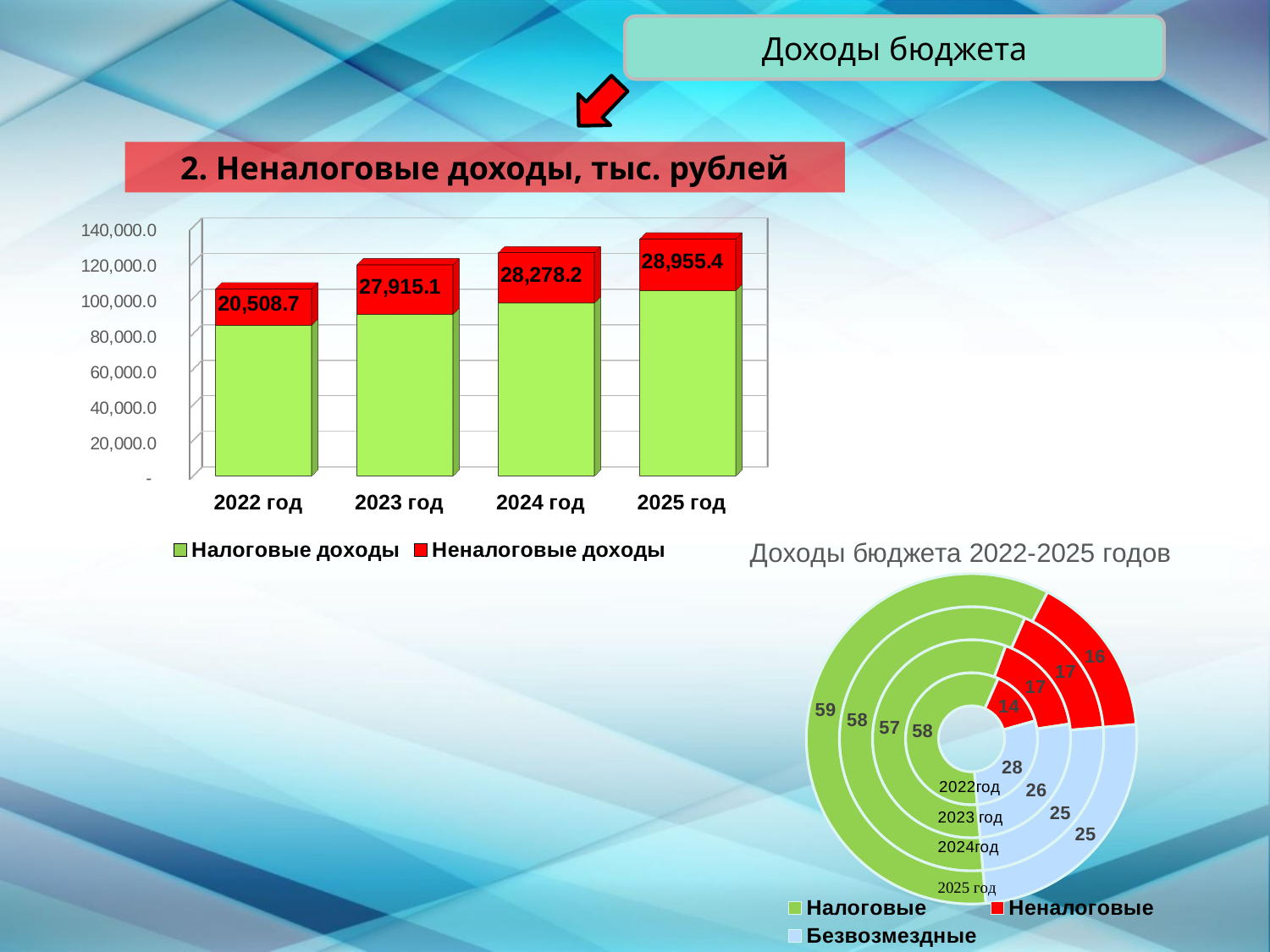
In the bar chart '2. Неналоговые доходы, тыс. рублей', is the total height of the 2022 год bar greater or less than 120,000.0? less In the bar chart '2. Неналоговые доходы, тыс. рублей', which year has the lowest Неналоговые доходы value? 2022 год In the bar chart '2. Неналоговые доходы, тыс. рублей', what is the difference between the Неналоговые доходы values for 2023 год and 2022 год? 7,406.4 In the chart 'Доходы бюджета 2022-2025 годов', what is the Налоговые share for 2025 год (outermost ring)? 59 In the bar chart '2. Неналоговые доходы, тыс. рублей', what is the value of Неналоговые доходы for 2022 год? 20,508.7 What type of chart is '2. Неналоговые доходы, тыс. рублей'? stacked bar chart In the bar chart '2. Неналоговые доходы, тыс. рублей', what is the value of Неналоговые доходы for 2025 год? 28,955.4 In the chart 'Доходы бюджета 2022-2025 годов', how many series does the legend list? 3 In the chart 'Доходы бюджета 2022-2025 годов', what is the Неналоговые share for 2022 год (innermost ring)? 14 In the bar chart '2. Неналоговые доходы, тыс. рублей', how many series does the legend list? 2 In the bar chart '2. Неналоговые доходы, тыс. рублей', do the Неналоговые доходы values rise or fall from 2022 год to 2025 год? rise In the chart 'Доходы бюджета 2022-2025 годов', what is the Безвозмездные share for 2023 год? 26